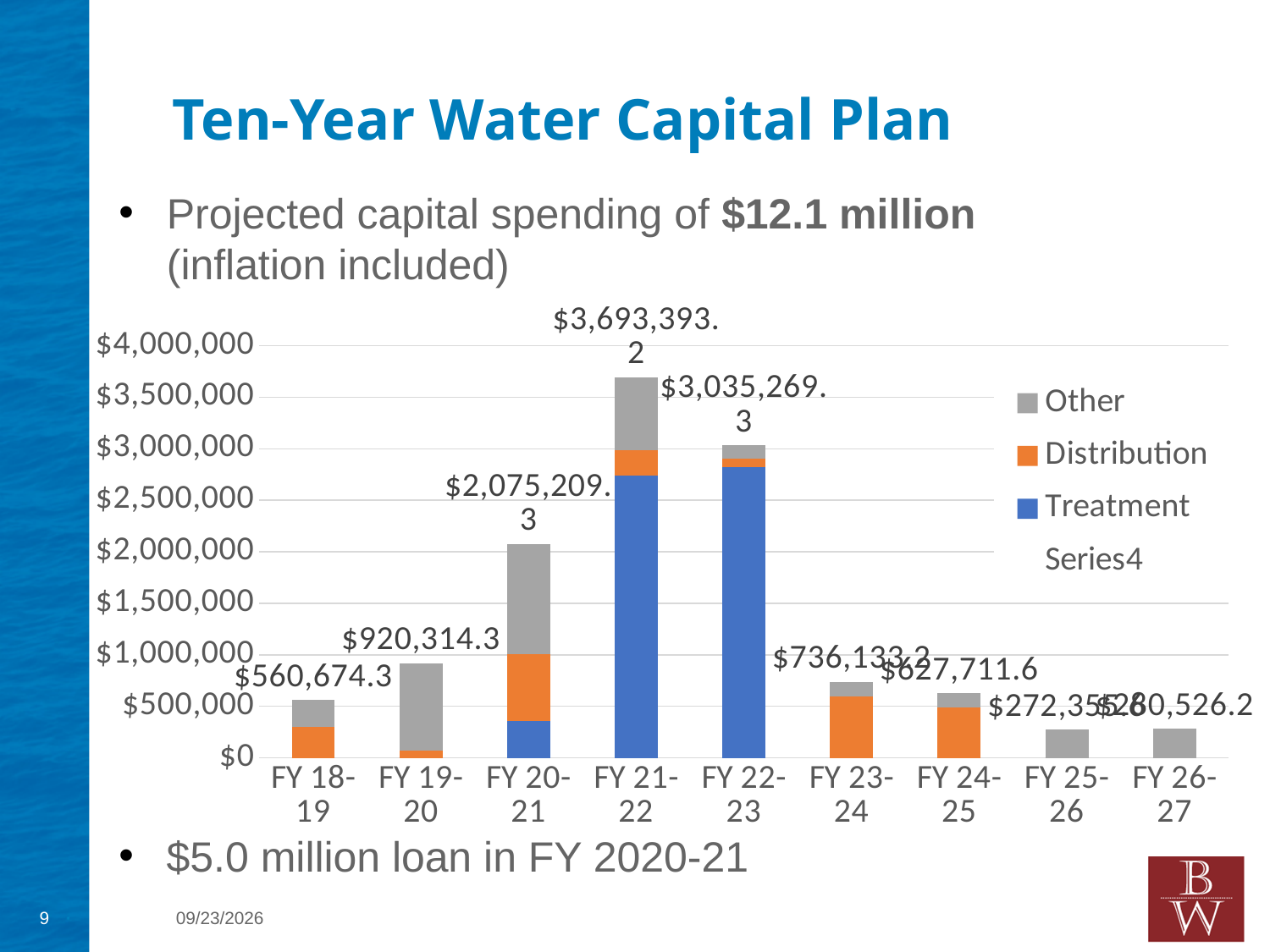
Which is larger, the total for FY 23-24 or the total for FY 24-25? FY 23-24 What is the total labeled for FY 21-22? $3,693,393.2 What is the total labeled for FY 20-21? $2,075,209.3 What is the difference between the totals for FY 21-22 and FY 22-23? $658,123.9 Is the total for FY 19-20 greater or less than $1,000,000? less Which colour represents Treatment in the chart's legend? blue What is the total labeled for FY 18-19? $560,674.3 What kind of chart is shown on the slide? bar chart What is the total labeled for FY 26-27? $280,526.2 How many fiscal years are shown on the x axis of the chart? 9 How many entries does the chart's legend list? 4 Which fiscal year has the highest total projected capital spending? FY 21-22